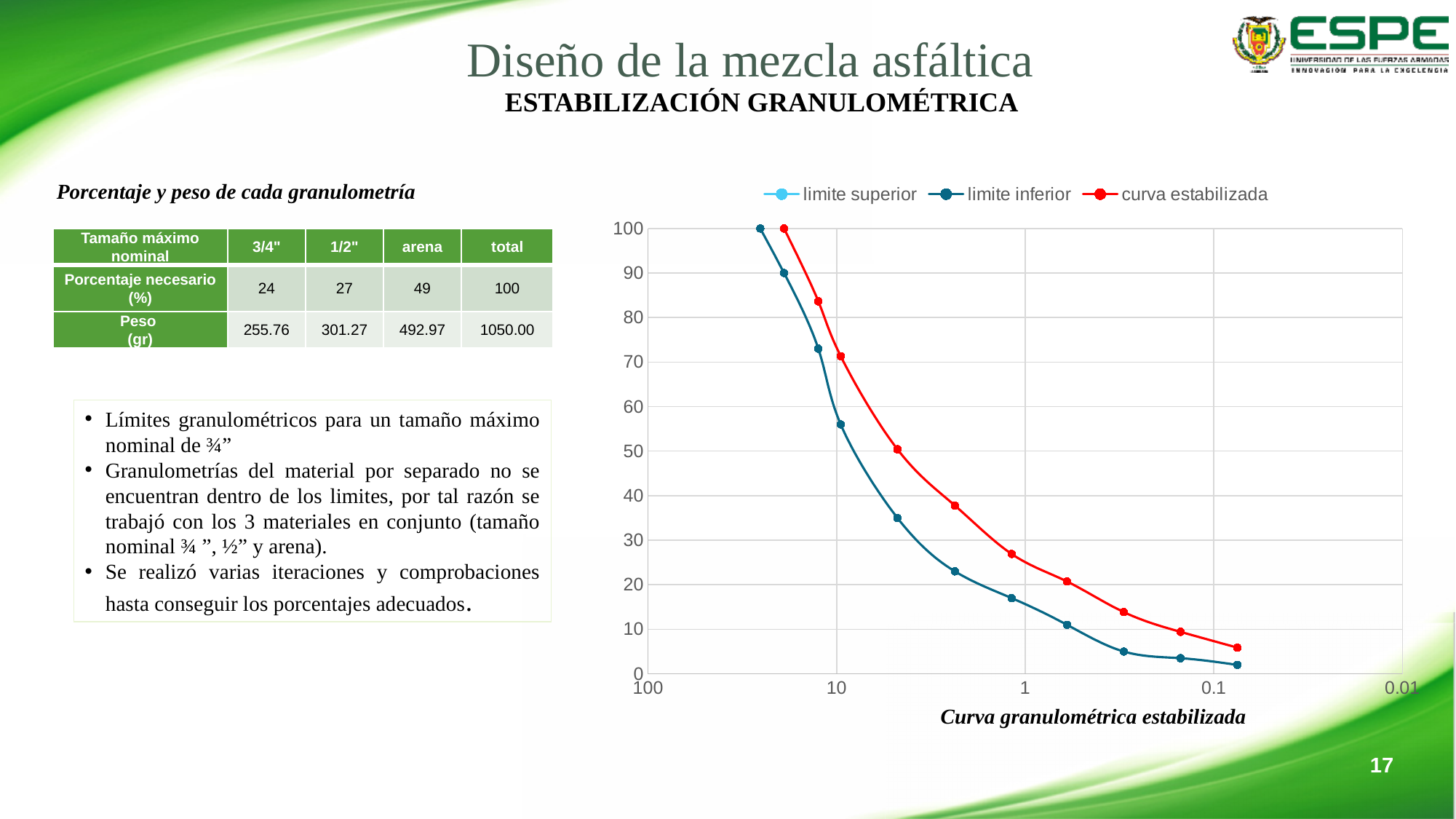
Is the last (rightmost) value of the curva estabilizada series greater or less than 10? less Do the plotted values rise or fall moving from left to right along the x axis? fall What is the caption printed below the chart? Curva granulométrica estabilizada What is the starting (leftmost) value of the limite inferior series? 100 Is the last (rightmost) value of the limite inferior series greater or less than 10? less How many series does the chart legend list? 3 What are the three series named in the chart legend? limite superior, limite inferior, curva estabilizada What is the starting (leftmost) value of the curva estabilizada series? 100 What is the highest value shown on the chart's y axis? 100 Is the curva estabilizada value at the x-axis tick 10 greater or less than 60? greater Which series lies higher on the chart, curva estabilizada or limite inferior? curva estabilizada What kind of chart is shown on the slide? line chart